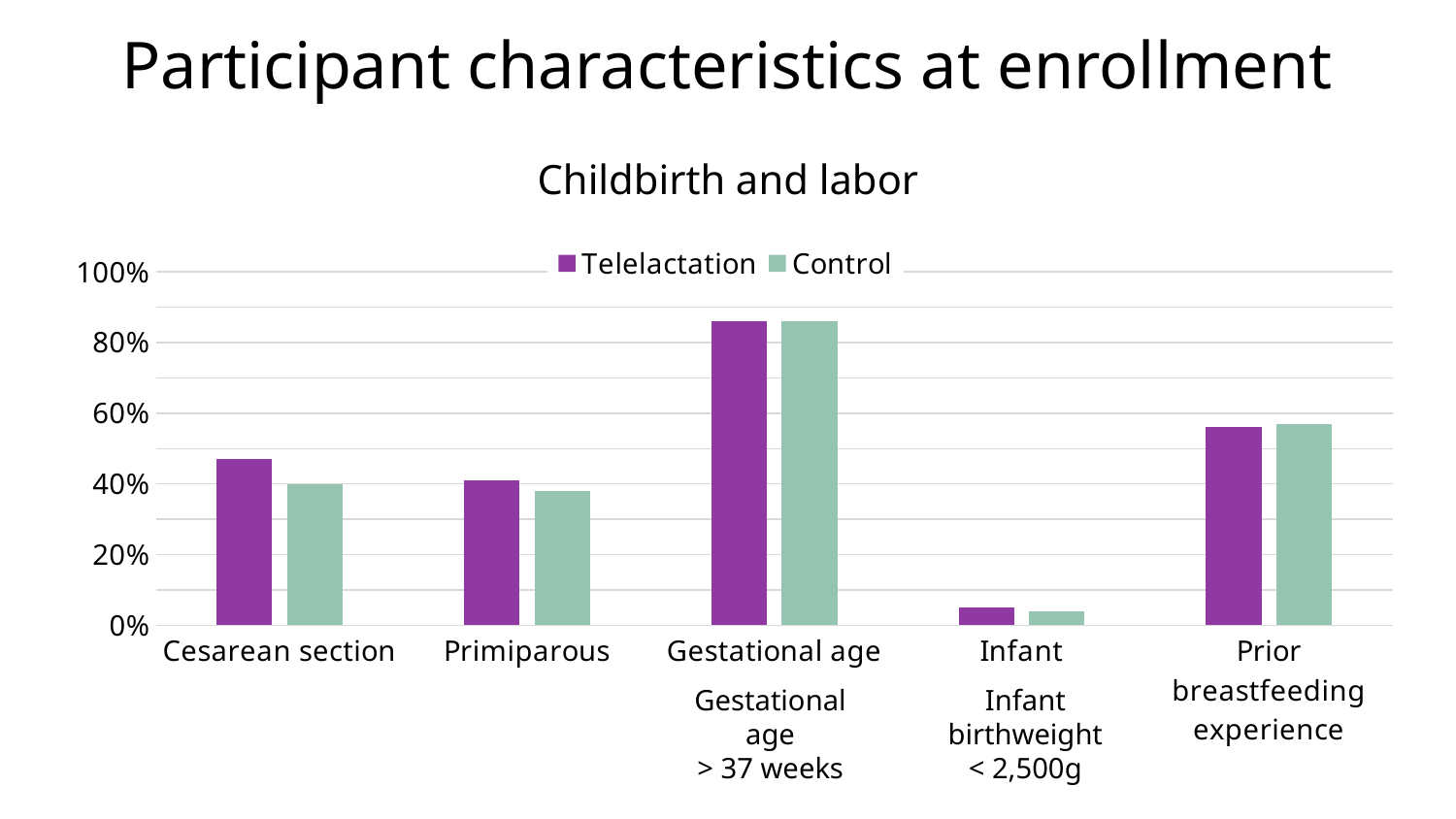
Is the Control value for Primiparous greater or less than 60%? less For Cesarean section, which series has the larger value, Telelactation or Control? Telelactation How many series does the legend list? 2 Is the Control value for Infant greater or less than 20%? less What kind of chart is shown on the slide? bar chart Which category has the lowest value for the Control series? Infant Which category has the highest value for the Telelactation series? Gestational age Is the Telelactation value for Gestational age greater or less than 80%? greater How many categories are shown on the x axis? 5 Which series is shown in purple? Telelactation What is the title of the chart? Childbirth and labor